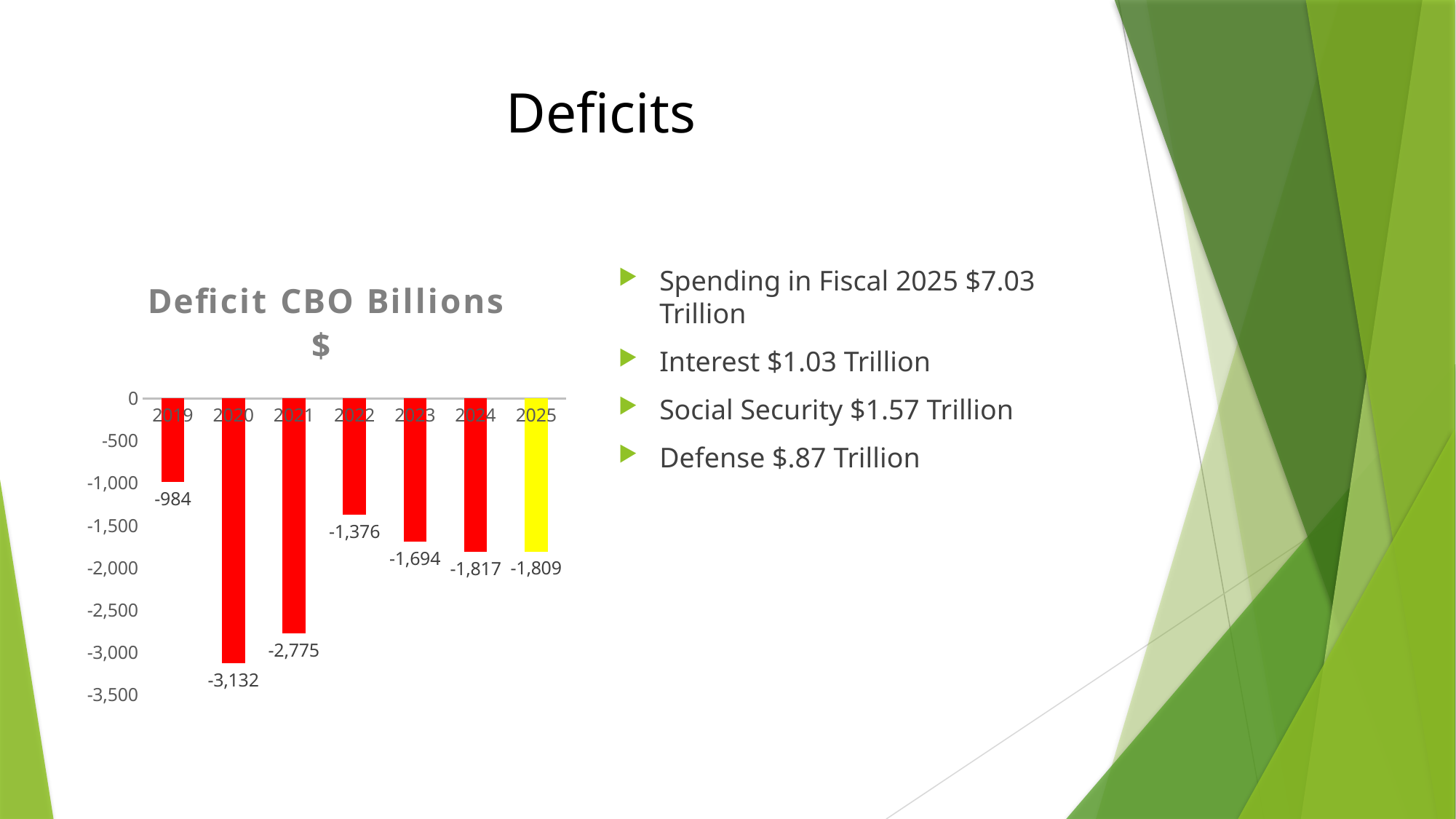
What is the value for 2019 in the Deficit CBO Billions $ chart? -984 What kind of chart is the Deficit CBO Billions $ chart? Bar chart What is the value for 2022 in the Deficit CBO Billions $ chart? -1,376 Which year has the lowest (most negative) value in the Deficit CBO Billions $ chart? 2020 What colour is the bar for 2025 in the Deficit CBO Billions $ chart? Yellow Which year shows a larger deficit in the Deficit CBO Billions $ chart, 2022 or 2023? 2023 Which year has the highest (least negative) value in the Deficit CBO Billions $ chart? 2019 What is the difference between the values for 2020 and 2019 in the Deficit CBO Billions $ chart? 2,148 How many years are plotted in the Deficit CBO Billions $ chart? 7 What is the difference between the values for 2024 and 2025 in the Deficit CBO Billions $ chart? 8 What is the value for 2025 in the Deficit CBO Billions $ chart? -1,809 What is the value for 2020 in the Deficit CBO Billions $ chart? -3,132